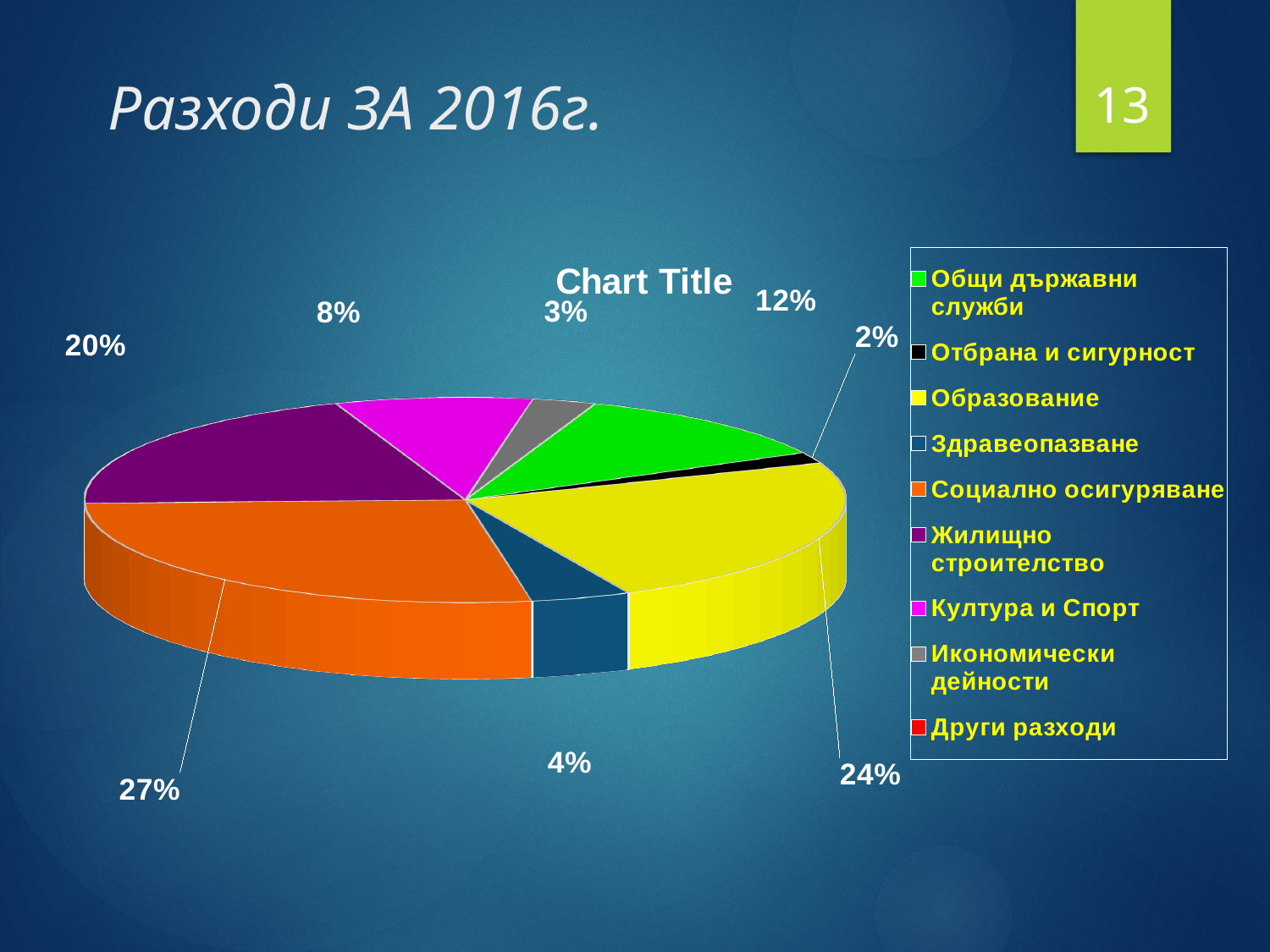
What type of chart is shown on the slide? Pie chart What percentage is shown for Култура и Спорт? 8% What percentage is shown for Отбрана и сигурност? 2% Which is larger, the share for Жилищно строителство or the share for Общи държавни служби? Жилищно строителство What percentage is shown for Социално осигуряване? 27% How many categories does the legend list? 9 What percentage is shown for Жилищно строителство? 20% What percentage is shown for Образование? 24% What percentage is shown for Здравеопазване? 4% What is the difference in percentage points between Социално осигуряване and Образование? 3 What percentage is shown for Общи държавни служби? 12% Which category has the largest share of the pie? Социално осигуряване